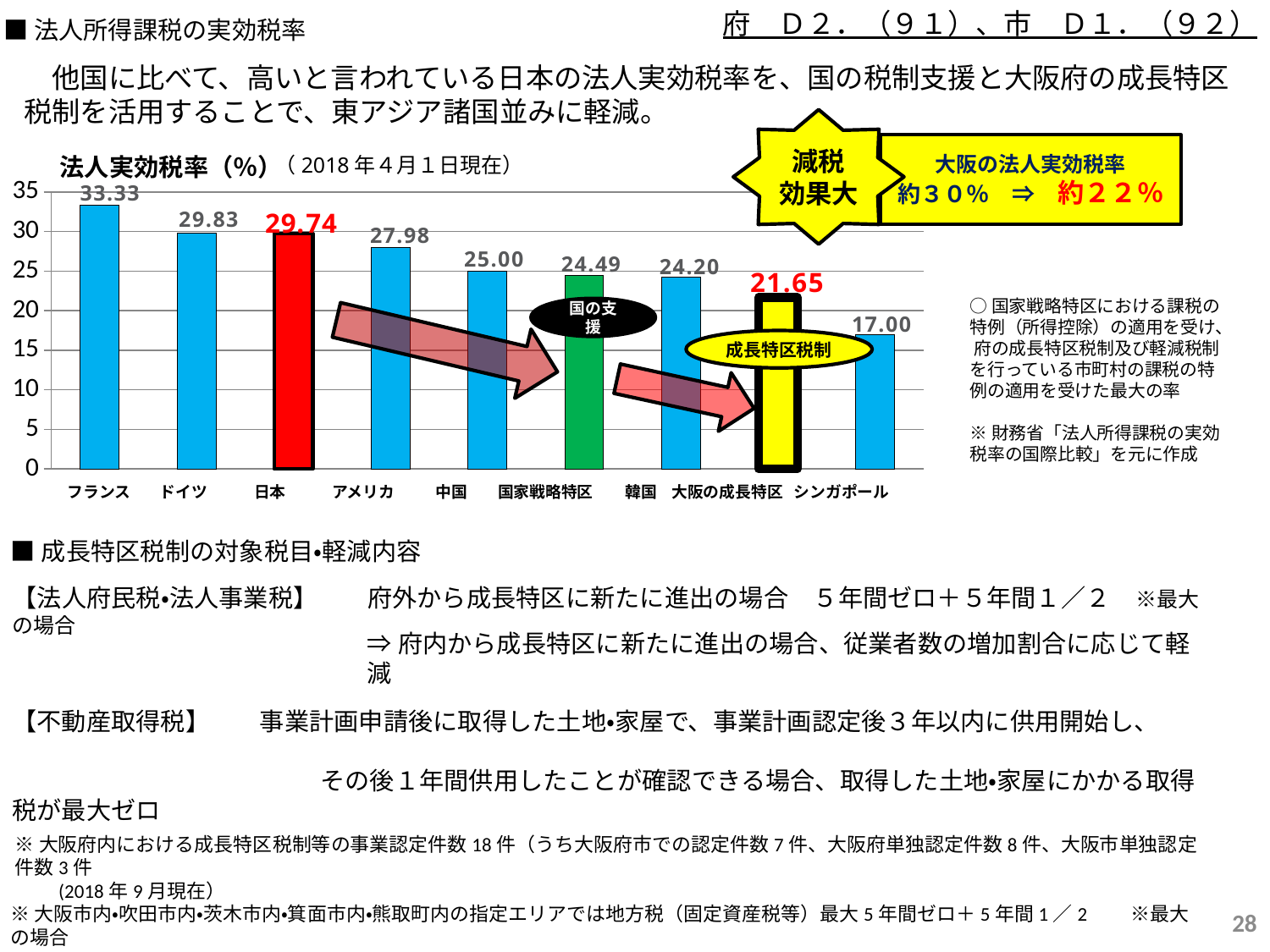
What is the value for 大阪の成長特区 in the 法人実効税率 chart? 21.65 Is the value for 韓国 in the 法人実効税率 chart greater or less than 25? less What is the value for フランス in the 法人実効税率 chart? 33.33 Which category has the highest value in the 法人実効税率 chart? フランス Do the values in the 法人実効税率 chart generally rise or fall from left to right? fall Which category has the lowest value in the 法人実効税率 chart? シンガポール What is the value for 日本 in the 法人実効税率 chart? 29.74 What is the value for 国家戦略特区 in the 法人実効税率 chart? 24.49 How many categories are shown in the 法人実効税率 chart? 9 What is the difference between the values for 日本 and 大阪の成長特区 in the 法人実効税率 chart? 8.09 What kind of chart is the 法人実効税率 chart? bar chart Which is larger in the 法人実効税率 chart, the value for アメリカ or the value for 中国? アメリカ